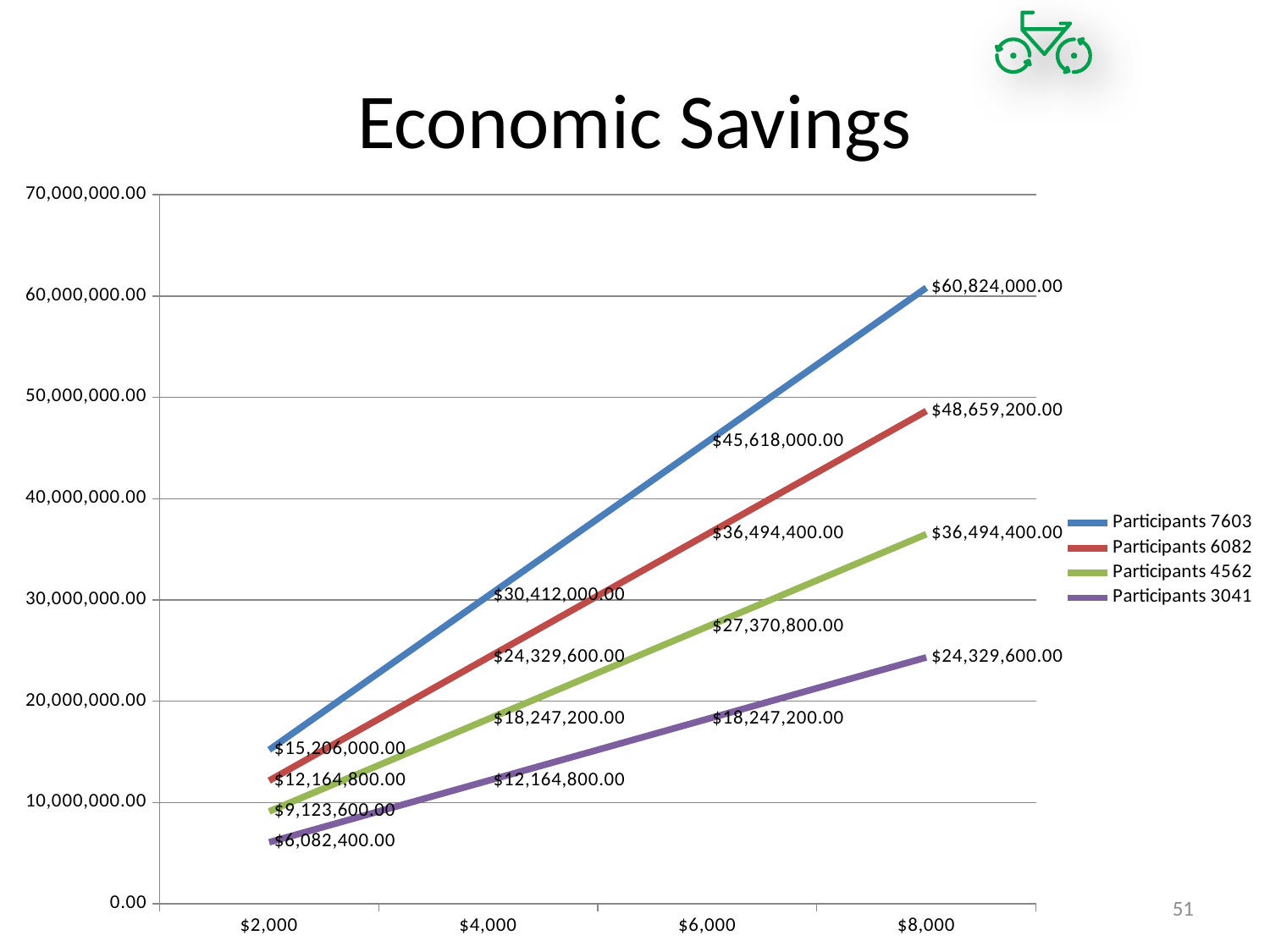
What type of chart is shown on the slide? Line chart How many points are plotted along the x axis for each series? 4 Which series has the lowest value at $2,000? Participants 3041 What is the title of the chart? Economic Savings What is the value for Participants 3041 at $2,000? $6,082,400.00 Do the values for Participants 4562 rise or fall as the x axis goes from $2,000 to $8,000? Rise How many series does the legend list? 4 Which series has the highest value at $8,000? Participants 7603 What is the value for Participants 4562 at $4,000? $18,247,200.00 What is the difference between the Participants 7603 value and the Participants 6082 value at $8,000? $12,164,800.00 What is the value for Participants 6082 at $6,000? $36,494,400.00 What is the value for Participants 7603 at $8,000? $60,824,000.00